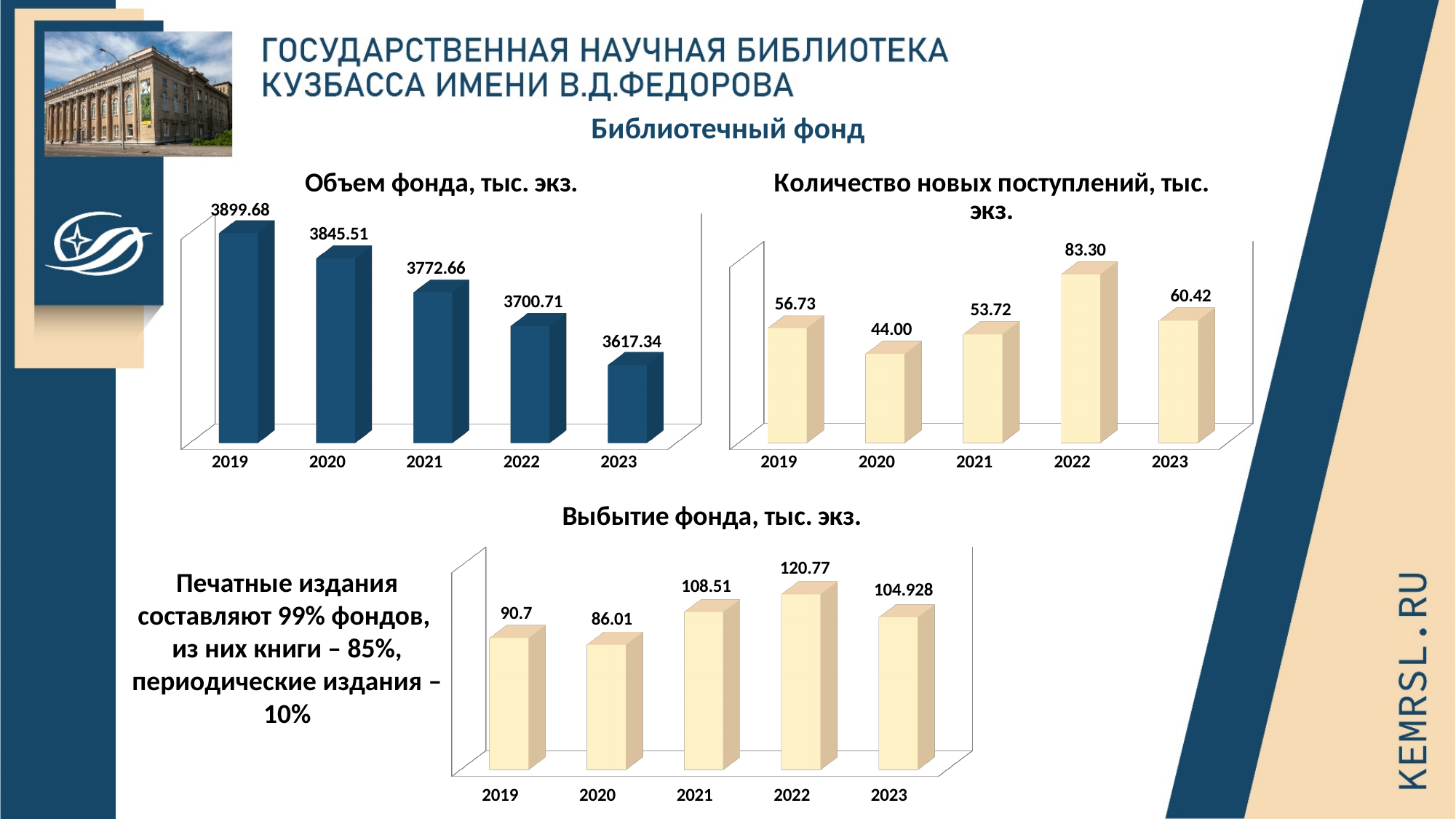
In the chart 'Количество новых поступлений, тыс. экз.', which year has the highest value? 2022 In the chart 'Количество новых поступлений, тыс. экз.', which is larger: the value for 2019 or the value for 2021? 2019 In the chart 'Объем фонда, тыс. экз.', do the values rise or fall from 2019 to 2023? fall In the chart 'Объем фонда, тыс. экз.', what is the difference between the 2019 and 2023 values? 282.34 In the chart 'Выбытие фонда, тыс. экз.', what is the value for 2023? 104.928 How many years are shown in the chart 'Выбытие фонда, тыс. экз.'? 5 In the chart 'Объем фонда, тыс. экз.', what is the value for 2021? 3772.66 In the chart 'Выбытие фонда, тыс. экз.', which year has the lowest value? 2020 In the chart 'Количество новых поступлений, тыс. экз.', what is the value for 2020? 44.00 What type of chart is 'Объем фонда, тыс. экз.'? bar chart In the chart 'Количество новых поступлений, тыс. экз.', what is the difference between the 2022 and 2023 values? 22.88 In the chart 'Объем фонда, тыс. экз.', which year has the lowest value? 2023